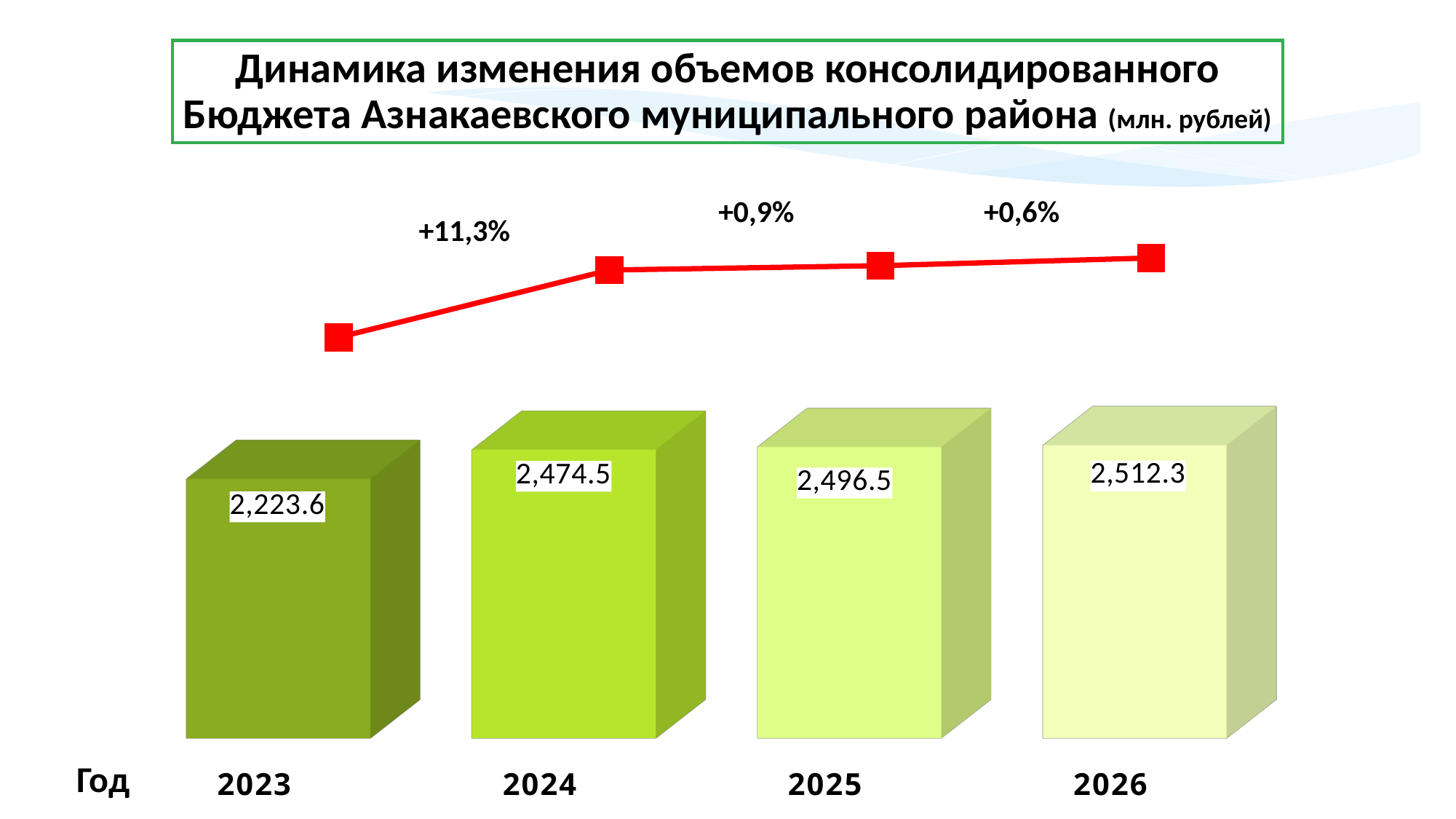
Which is larger, the budget value for 2023 or for 2024? 2024 What is the budget value shown for 2024? 2,474.5 Which year has the highest budget value? 2026 What percentage change is labelled on the line between 2023 and 2024? +11,3% Which year has the lowest budget value? 2023 What is the difference between the 2024 and 2023 budget values? 250.9 What is the budget value shown for 2025? 2,496.5 What is the budget value shown for 2026? 2,512.3 What is the budget value shown for 2023? 2,223.6 What is the difference between the 2026 and 2023 budget values? 288.7 How many years are shown on the chart? 4 Do the budget values rise or fall from 2023 to 2026? rise